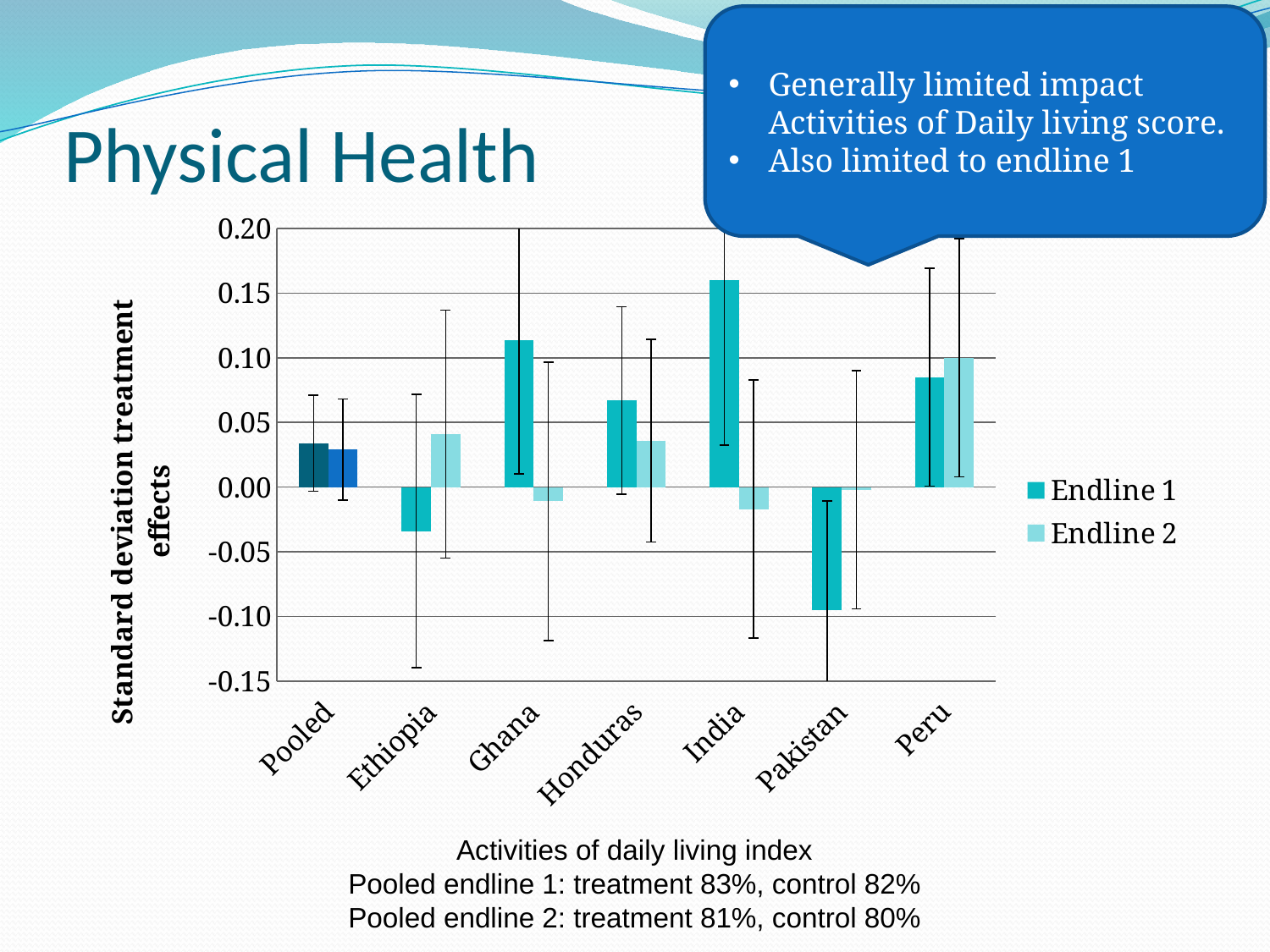
What is the title of the y axis? Standard deviation treatment effects How many countries/categories are shown on the x axis? 7 Which is larger, the Endline 2 value for Peru or the Endline 2 value for Honduras? Peru What kind of chart is shown on the slide? bar chart Which category has the highest Endline 1 value? India Which category has the lowest Endline 1 value? Pakistan Which is larger, the Endline 1 value for Ghana or the Endline 1 value for Honduras? Ghana Is the Endline 1 value for Ghana greater or less than 0.10? greater Is the Endline 1 value for Pakistan greater or less than -0.05? less Which category has the highest Endline 2 value? Peru How many series does the legend list? 2 Is the Endline 1 value for India greater or less than 0.15? greater